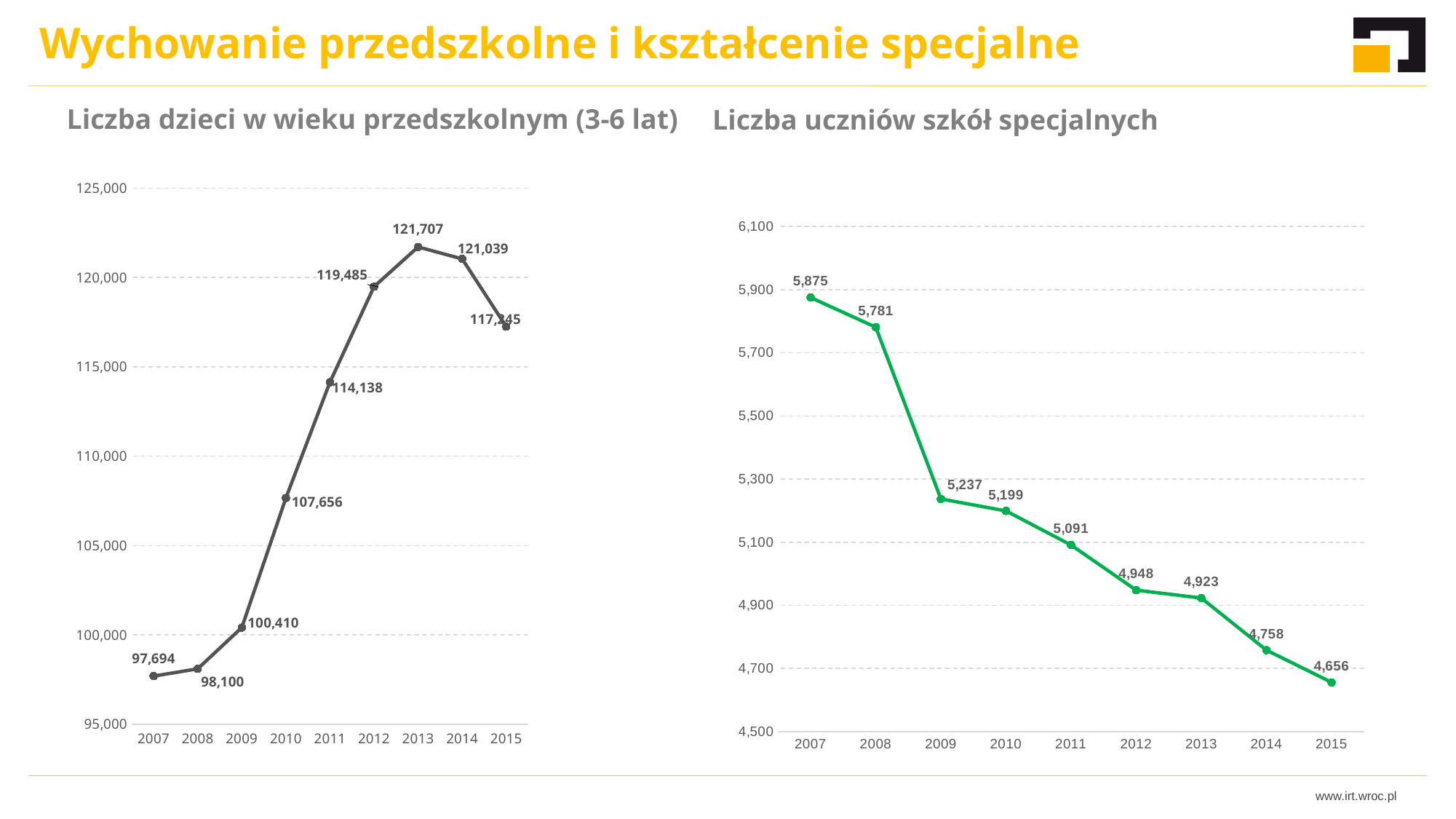
In the chart 'Liczba dzieci w wieku przedszkolnym (3-6 lat)', what is the value for 2013? 121,707 In the chart 'Liczba dzieci w wieku przedszkolnym (3-6 lat)', what is the value for 2007? 97,694 In the chart 'Liczba uczniów szkół specjalnych', what is the difference between the values for 2007 and 2015? 1,219 In the chart 'Liczba uczniów szkół specjalnych', what is the value for 2009? 5,237 In the chart 'Liczba uczniów szkół specjalnych', do the values rise or fall from 2007 to 2015? fall In the chart 'Liczba uczniów szkół specjalnych', which year has the highest value? 2007 In the chart 'Liczba dzieci w wieku przedszkolnym (3-6 lat)', which year has the lowest value? 2007 In the chart 'Liczba dzieci w wieku przedszkolnym (3-6 lat)', what is the difference between the values for 2011 and 2010? 6,482 In the chart 'Liczba dzieci w wieku przedszkolnym (3-6 lat)', is the value for 2015 greater or less than 115,000? greater In the chart 'Liczba dzieci w wieku przedszkolnym (3-6 lat)', which year has the highest value? 2013 How many years are plotted in the chart 'Liczba uczniów szkół specjalnych'? 9 In the chart 'Liczba uczniów szkół specjalnych', what is the value for 2015? 4,656